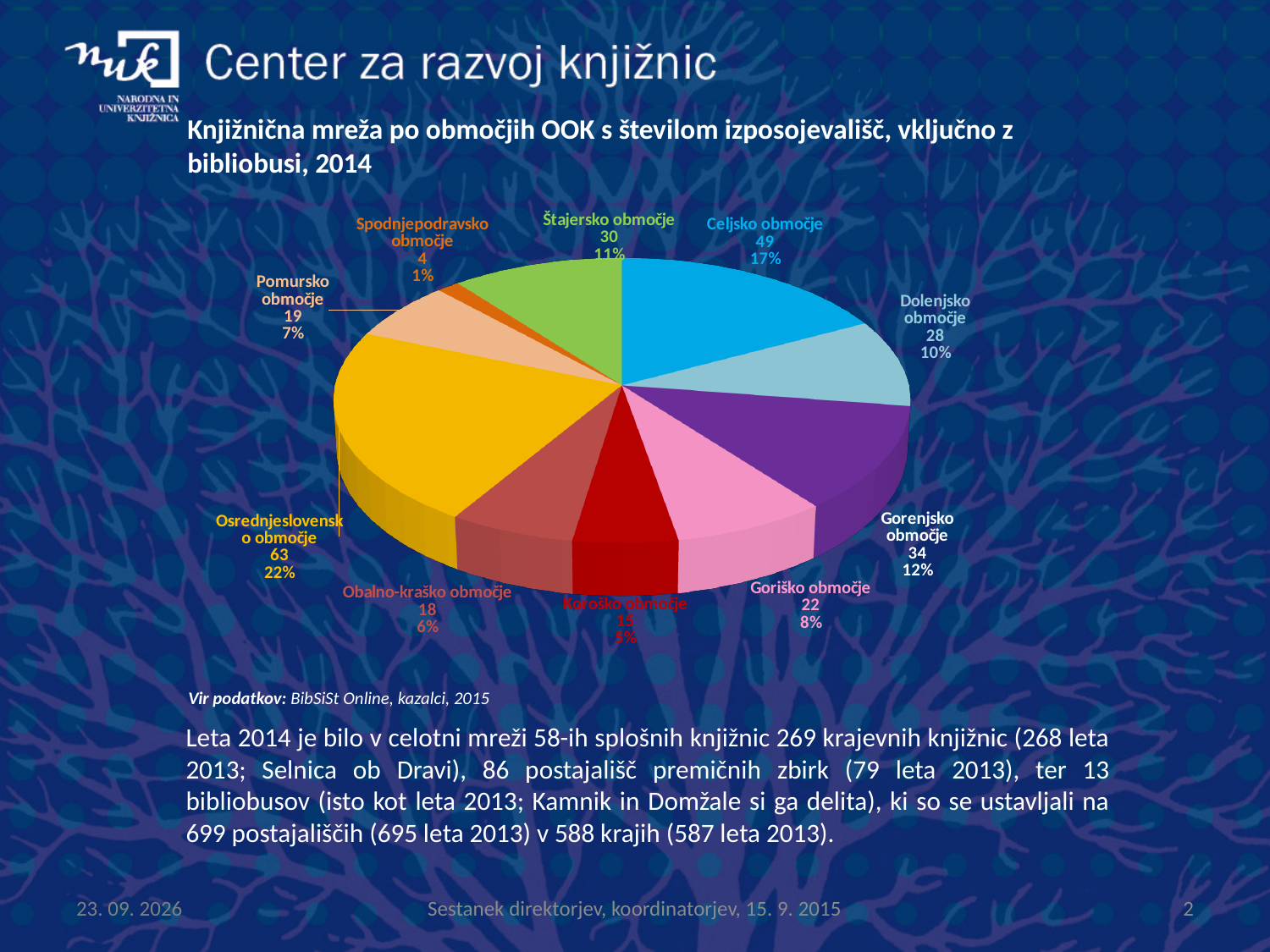
What is the value shown for Gorenjsko območje? 34 What percentage share does Dolenjsko območje have in the pie chart? 10% What percentage share does Osrednjeslovensko območje have in the pie chart? 22% What is the difference between the values for Celjsko območje and Štajersko območje? 19 Which has a larger value, Pomursko območje or Obalno-kraško območje? Pomursko območje Which region has the largest slice in the pie chart? Osrednjeslovensko območje What is the value shown for Spodnjepodravsko območje? 4 What is the value shown for Celjsko območje? 49 Which region has the smallest slice in the pie chart? Spodnjepodravsko območje What kind of chart is shown on the slide? pie chart What is the title of the chart on the slide? Knjižnična mreža po območjih OOK s številom izposojevališč, vključno z bibliobusi, 2014 How many slices does the pie chart have? 10